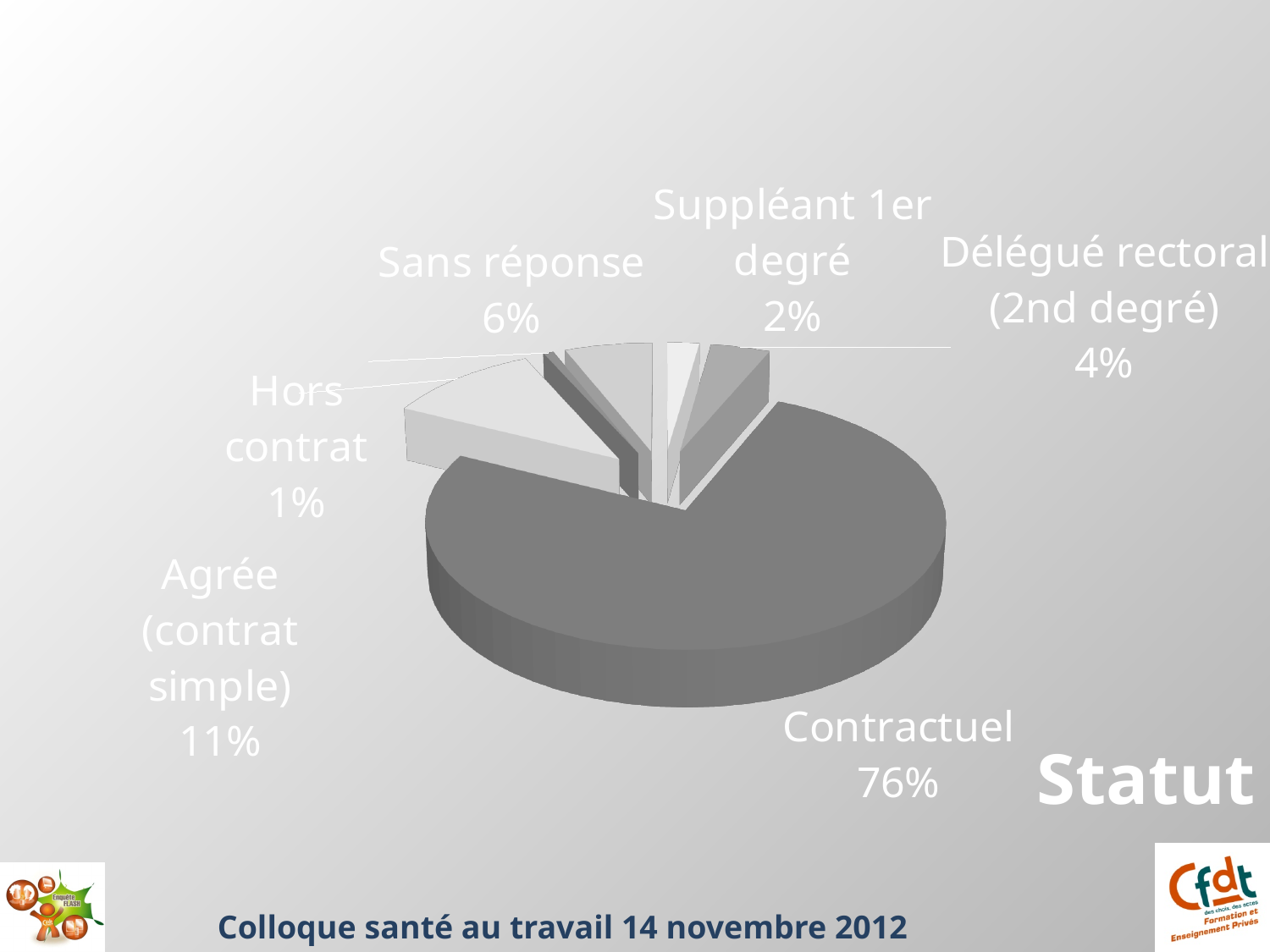
What is the value for Suppléant 1er degré? 2% What is the difference between the shares of Contractuel and Agrée (contrat simple)? 65% What is the value for Hors contrat? 1% What kind of chart is shown on the slide? Pie chart Which category has the largest share of the pie? Contractuel What share of the pie does Contractuel represent? 76% What is the title of the chart? Statut Which category has the smallest share of the pie? Hors contrat How many categories are shown in the pie chart? 6 What is the value for Délégué rectoral (2nd degré)? 4% What is the value for Agrée (contrat simple)? 11% What is the value for Sans réponse? 6%